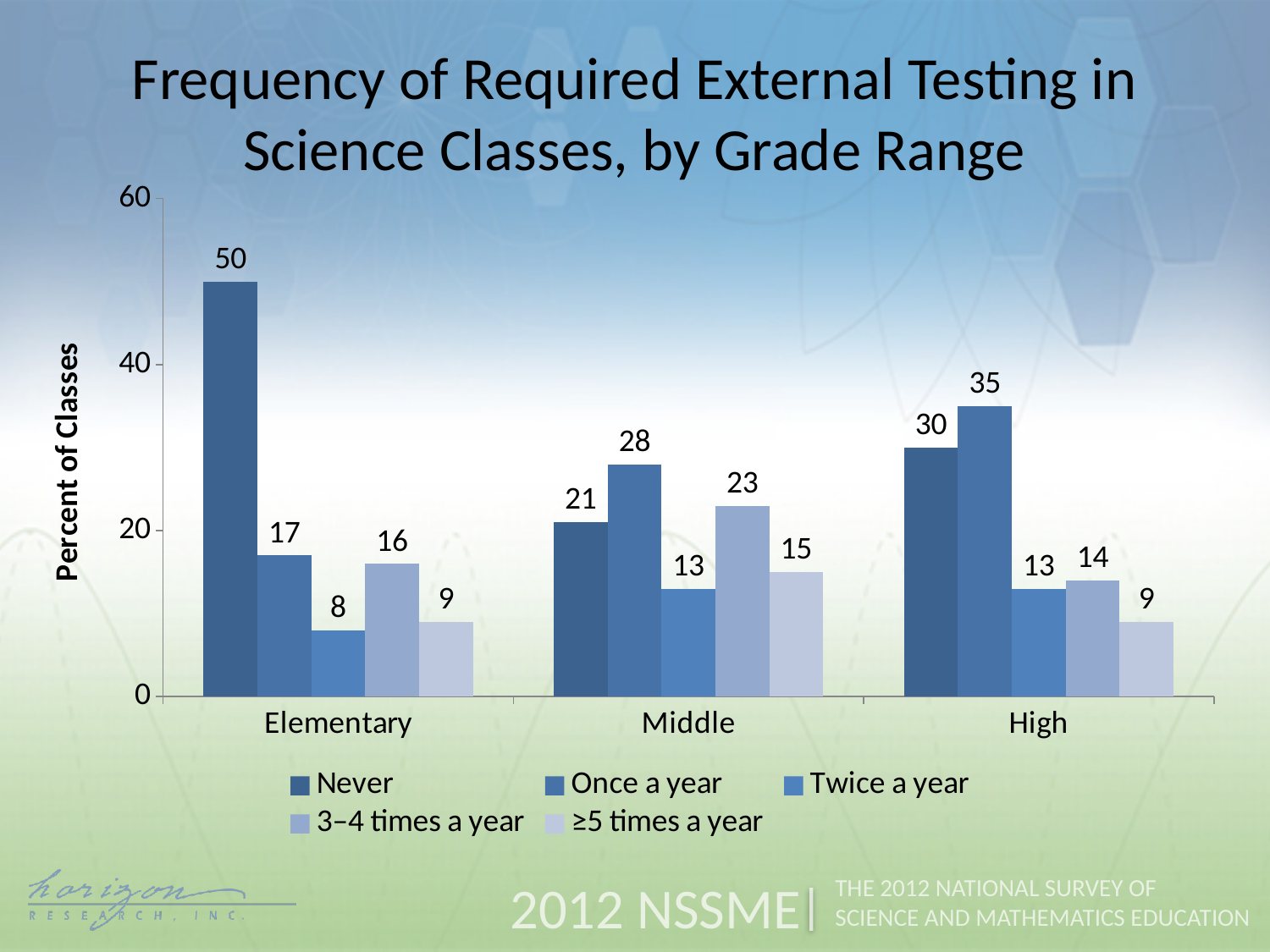
What percent of elementary science classes report 'Never' for required external testing? 50 What is the value for 'Once a year' in the High grade range? 35 What is the difference between the 'Never' values for Elementary and High? 20 Which testing frequency has the lowest value in the Elementary grade range? Twice a year How many series does the legend list? 5 How many grade ranges are shown on the x axis? 3 Which grade range has the highest value for 'Never'? Elementary Is the value for 'Once a year' in the Elementary grade range greater or less than 20? less What is the label of the y axis? Percent of Classes What kind of chart is shown on the slide? Bar chart What is the value for '3–4 times a year' in the Middle grade range? 23 Which is larger in the Middle grade range: 'Once a year' or 'Twice a year'? Once a year